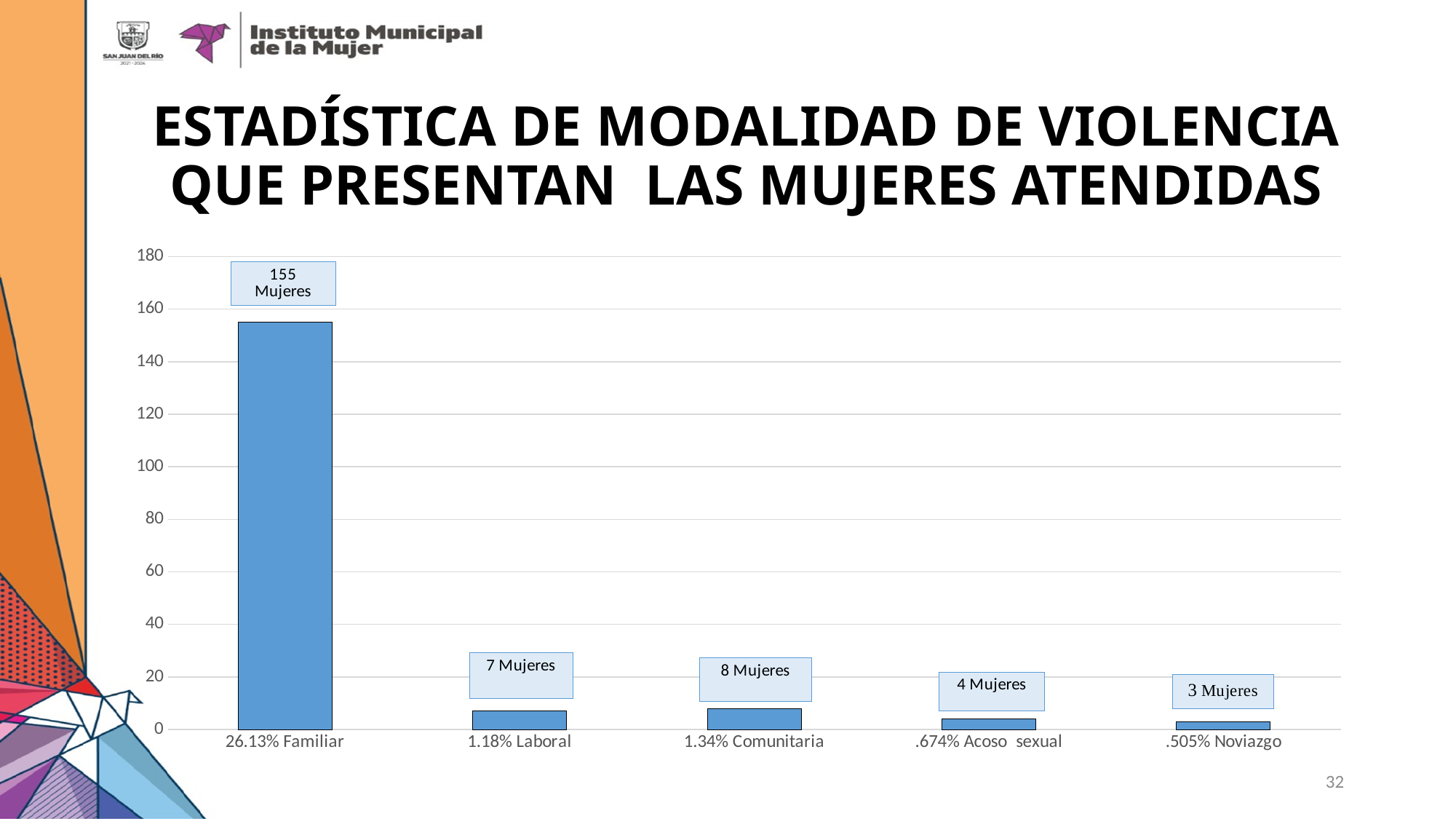
What is the value shown for the Laboral category? 7 Mujeres What percentage is shown next to the Acoso sexual category label? .674% How many categories are shown on the x axis? 5 Which category has the lowest bar? Noviazgo Which is larger, the value for Laboral or the value for Comunitaria? Comunitaria What is the value shown for the Comunitaria category? 8 Mujeres Is the value for Familiar greater or less than 140? greater How many women are shown for the Familiar category? 155 Mujeres What is the difference in number of women between Familiar and Comunitaria? 147 What kind of chart is shown on the slide? Bar chart Which category has the highest bar? Familiar What is the value shown for the Noviazgo category? 3 Mujeres